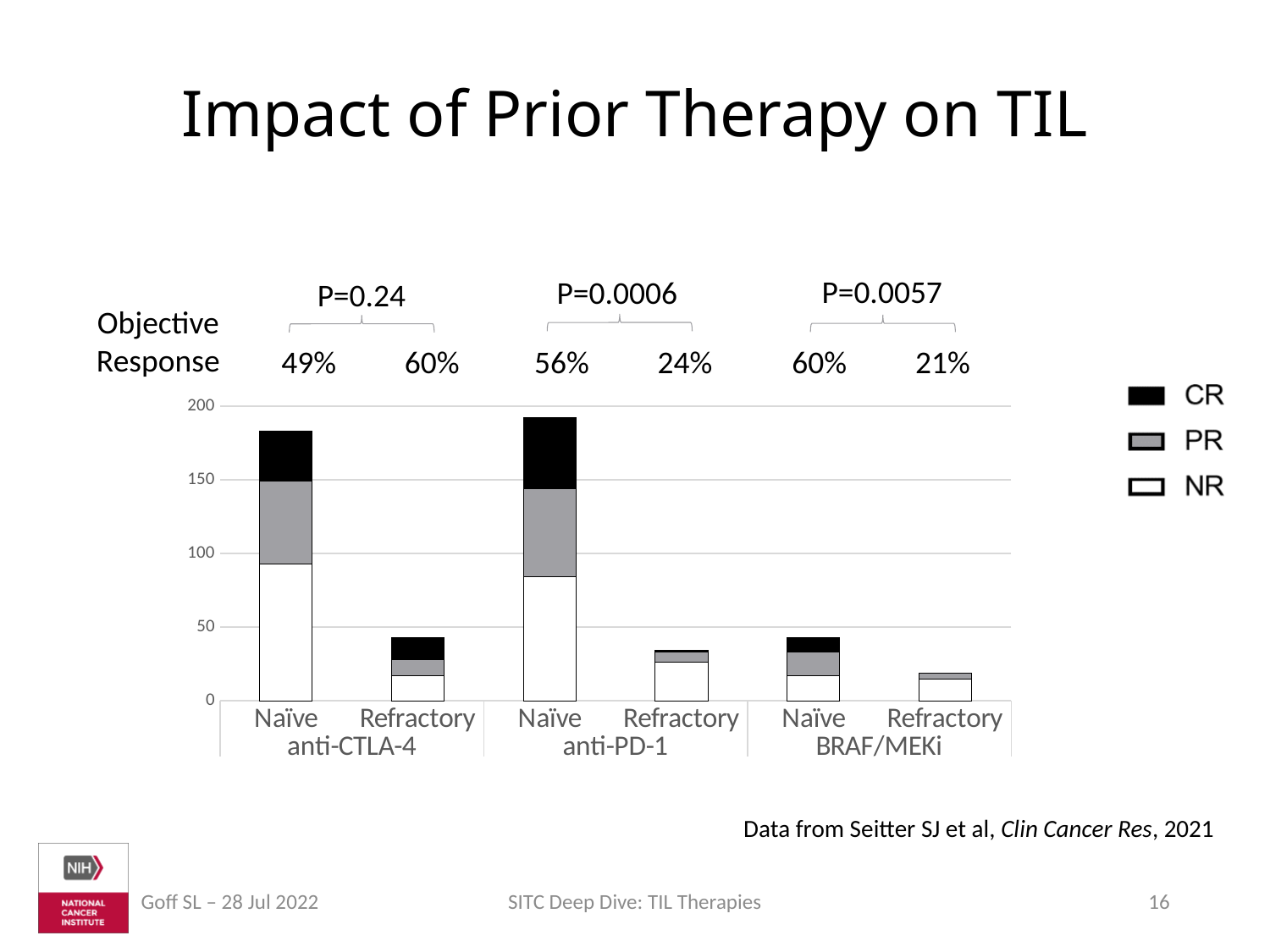
What P value is shown for the anti-CTLA-4 comparison? P=0.24 How many bars are plotted in the chart? 6 Is the total for the anti-PD-1 Refractory bar greater or less than 50? less Which bar is the tallest in the chart? anti-PD-1 Naïve Is the total for the anti-CTLA-4 Naïve bar greater or less than 150? greater What kind of chart is shown on the slide? stacked bar chart Which bar is taller, anti-PD-1 Naïve or anti-PD-1 Refractory? anti-PD-1 Naïve Which bar is the shortest in the chart? BRAF/MEKi Refractory Which legend entry is shown in black? CR What objective response rate is shown for the anti-PD-1 Refractory group? 24% What objective response rate is shown for the BRAF/MEKi Naïve group? 60% How many series does the legend list? 3